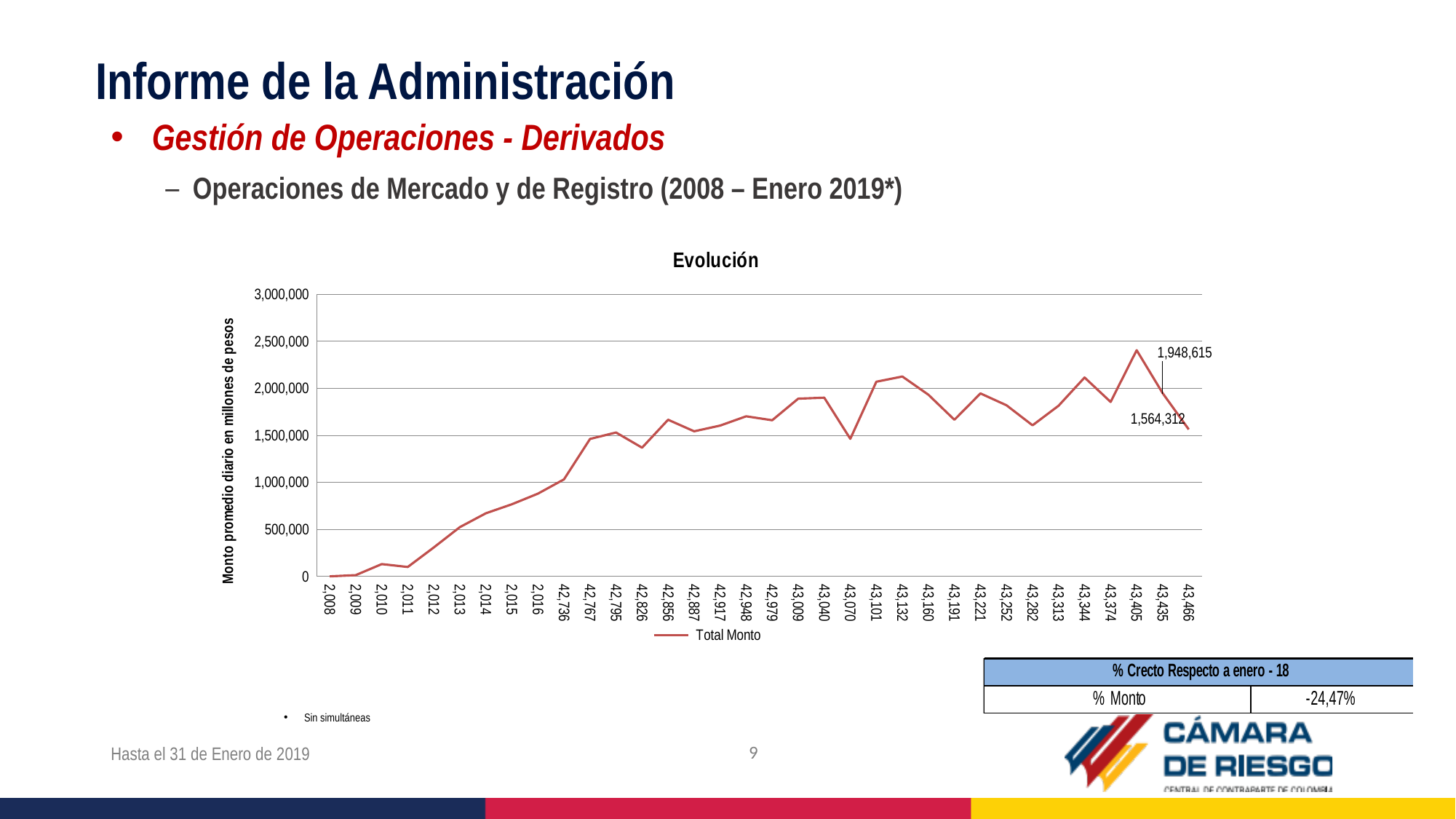
Is the value for 43,405 greater or less than 2,000,000? greater Which x-axis category has the lowest Total Monto value? 2,008 What is the title of the chart? Evolución What is the value of Total Monto at 43,466? 1,564,312 What is the value of Total Monto at 43,435? 1,948,615 Which x-axis category has the highest Total Monto value? 43,405 What is the label on the vertical axis of the chart? Monto promedio diario en millones de pesos What is the difference between the Total Monto values at 43,435 and 43,466? 384,303 Is the value for 2,016 greater or less than 1,000,000? less What kind of chart is shown on the slide? line chart Which has the larger Total Monto value, 43,435 or 43,466? 43,435 How many series does the chart legend list? 1